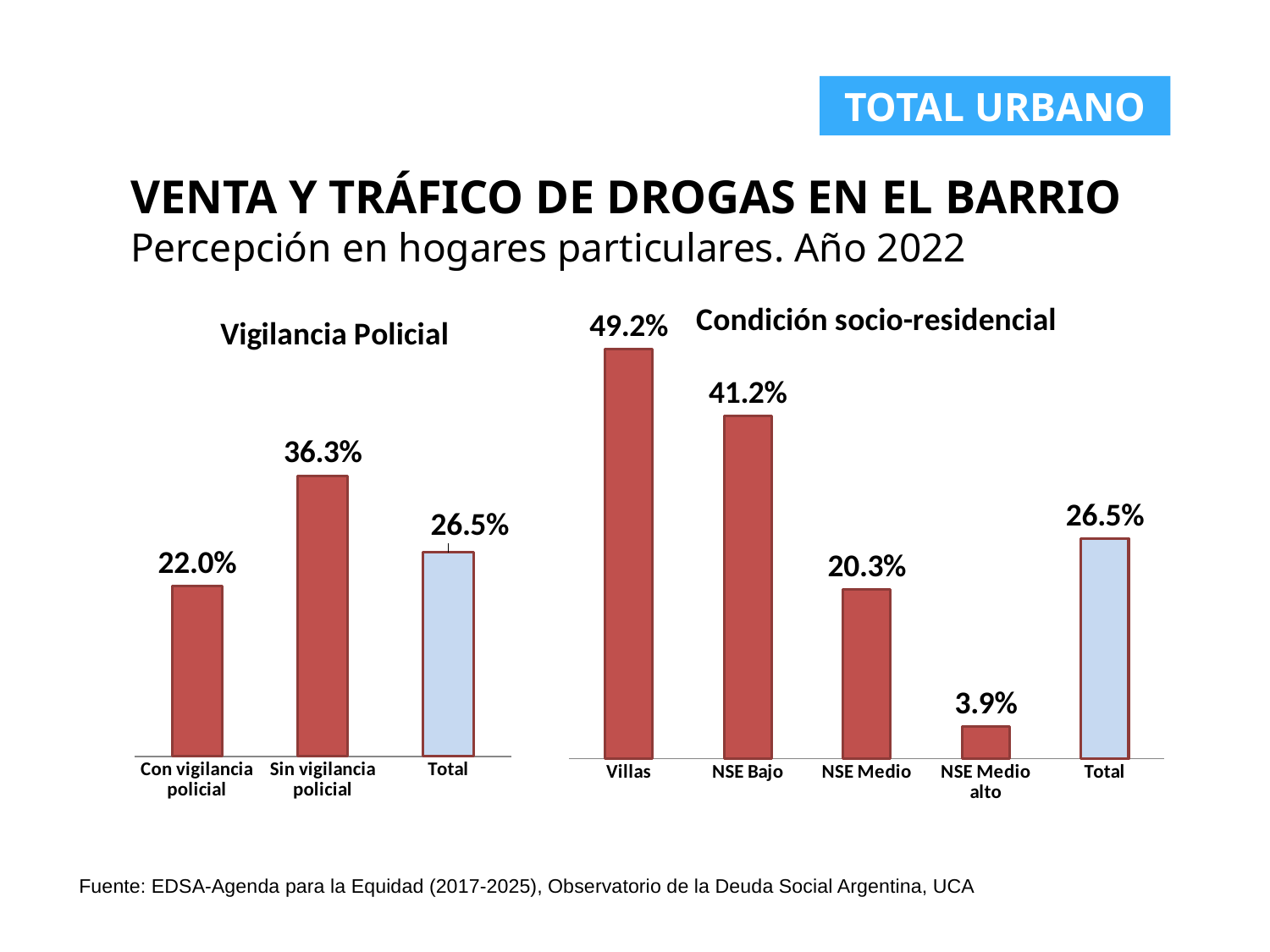
In the 'Condición socio-residencial' chart, what is the value for 'NSE Medio alto'? 3.9% In the 'Condición socio-residencial' chart, what is the value for 'Villas'? 49.2% In the 'Condición socio-residencial' chart, which category has the lowest value? NSE Medio alto In the 'Vigilancia Policial' chart, what is the value for 'Con vigilancia policial'? 22.0% In the 'Condición socio-residencial' chart, which is larger, 'NSE Medio' or 'Total'? Total How many categories are shown in the 'Condición socio-residencial' chart? 5 In the 'Vigilancia Policial' chart, what is the difference between 'Sin vigilancia policial' and 'Con vigilancia policial'? 14.3% What kind of chart is the 'Vigilancia Policial' chart? Bar chart In the 'Vigilancia Policial' chart, what is the value for 'Sin vigilancia policial'? 36.3% In the 'Condición socio-residencial' chart, which category has the highest value? Villas In the 'Vigilancia Policial' chart, which category has the highest value? Sin vigilancia policial In the 'Condición socio-residencial' chart, what is the difference between 'Villas' and 'NSE Bajo'? 8.0%